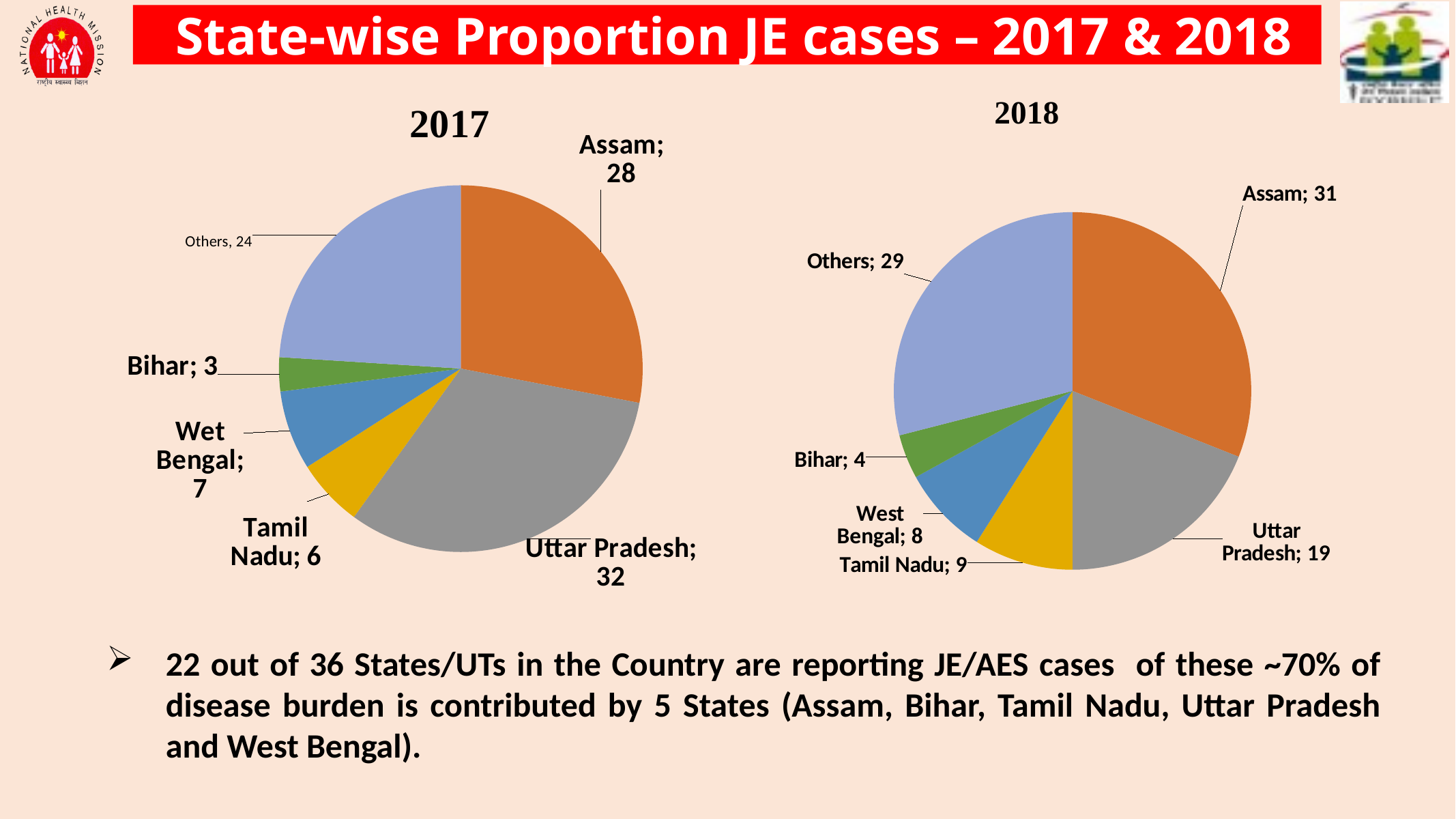
In the 2017 pie chart, what is the difference between the values for Uttar Pradesh and Assam? 4 What colour is the Assam slice in the 2018 pie chart? Orange In the 2017 pie chart, which category has the largest slice? Uttar Pradesh What type of chart is used for the 2017 data? Pie chart How many slices does the 2018 pie chart have? 6 In the 2018 pie chart, what is the value for Assam? 31 In the 2017 pie chart, what is the value for Tamil Nadu? 6 In the 2018 pie chart, what is the difference between the values for Assam and Uttar Pradesh? 12 In the 2017 pie chart, which is larger, the value for West Bengal or the value for Tamil Nadu? West Bengal In the 2017 pie chart, what is the value for Uttar Pradesh? 32 In the 2018 pie chart, which category has the smallest slice? Bihar In the 2018 pie chart, what is the value for Others? 29